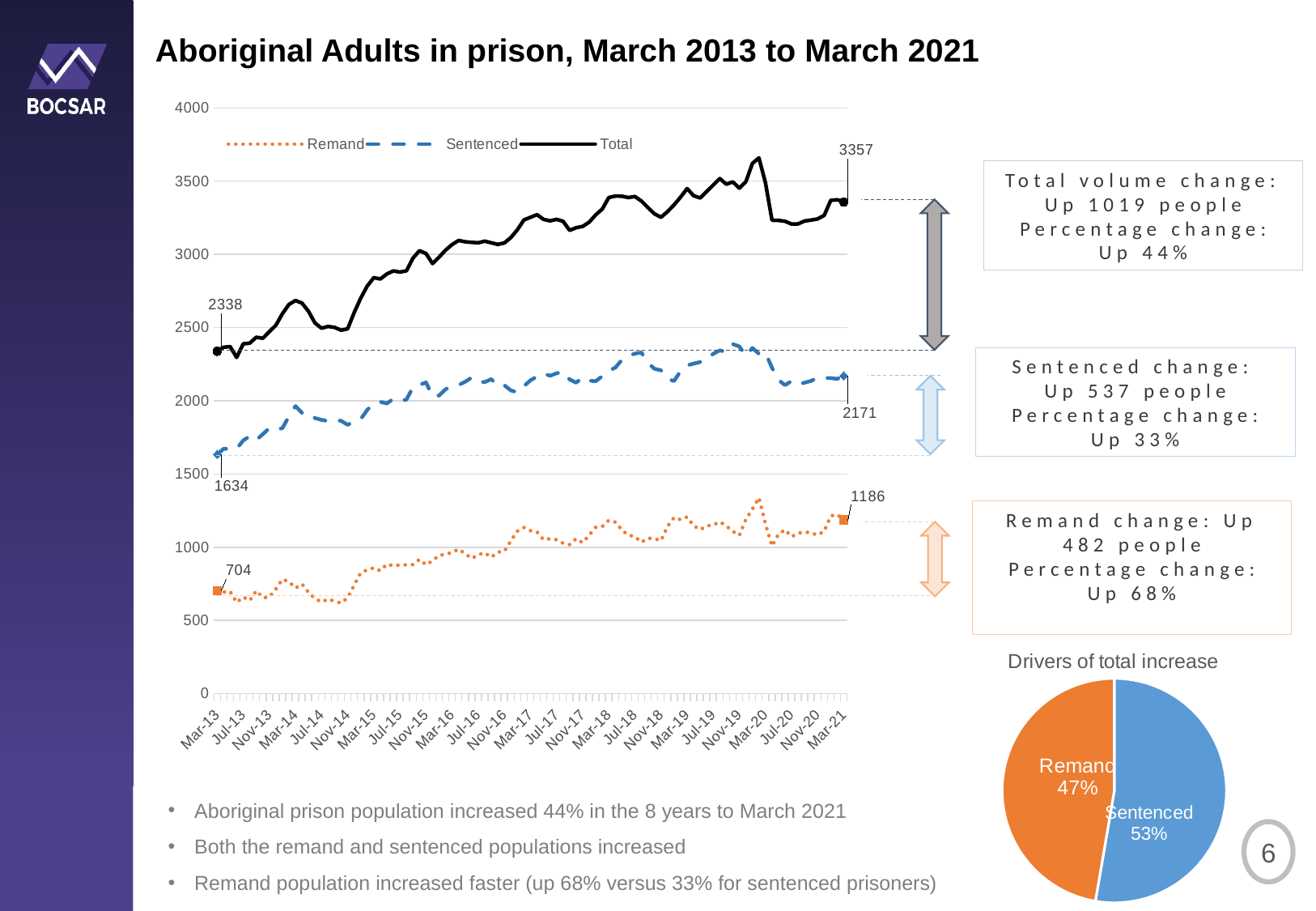
In the line chart, what was the Total value in March 2013? 2338 In the line chart, by how much did the Remand value increase from March 2013 (704) to March 2021 (1186)? 482 In the line chart, which series was higher in March 2021, Sentenced or Remand? Sentenced In the line chart, what was the Sentenced value in March 2021? 2171 In the 'Drivers of total increase' pie chart, what share does Sentenced account for? 53% In the line chart, what was the Remand value in March 2013? 704 How many series does the legend of the line chart list? 3 In the line chart, does the Total series generally rise or fall from March 2013 to March 2021? rise What kind of chart is the 'Drivers of total increase' chart? pie chart In the line chart, by how much did the Sentenced value increase from March 2013 (1634) to March 2021 (2171)? 537 In the line chart, what was the Total value in March 2021? 3357 In the line chart, is the Total value in March 2021 greater or less than 3000? greater